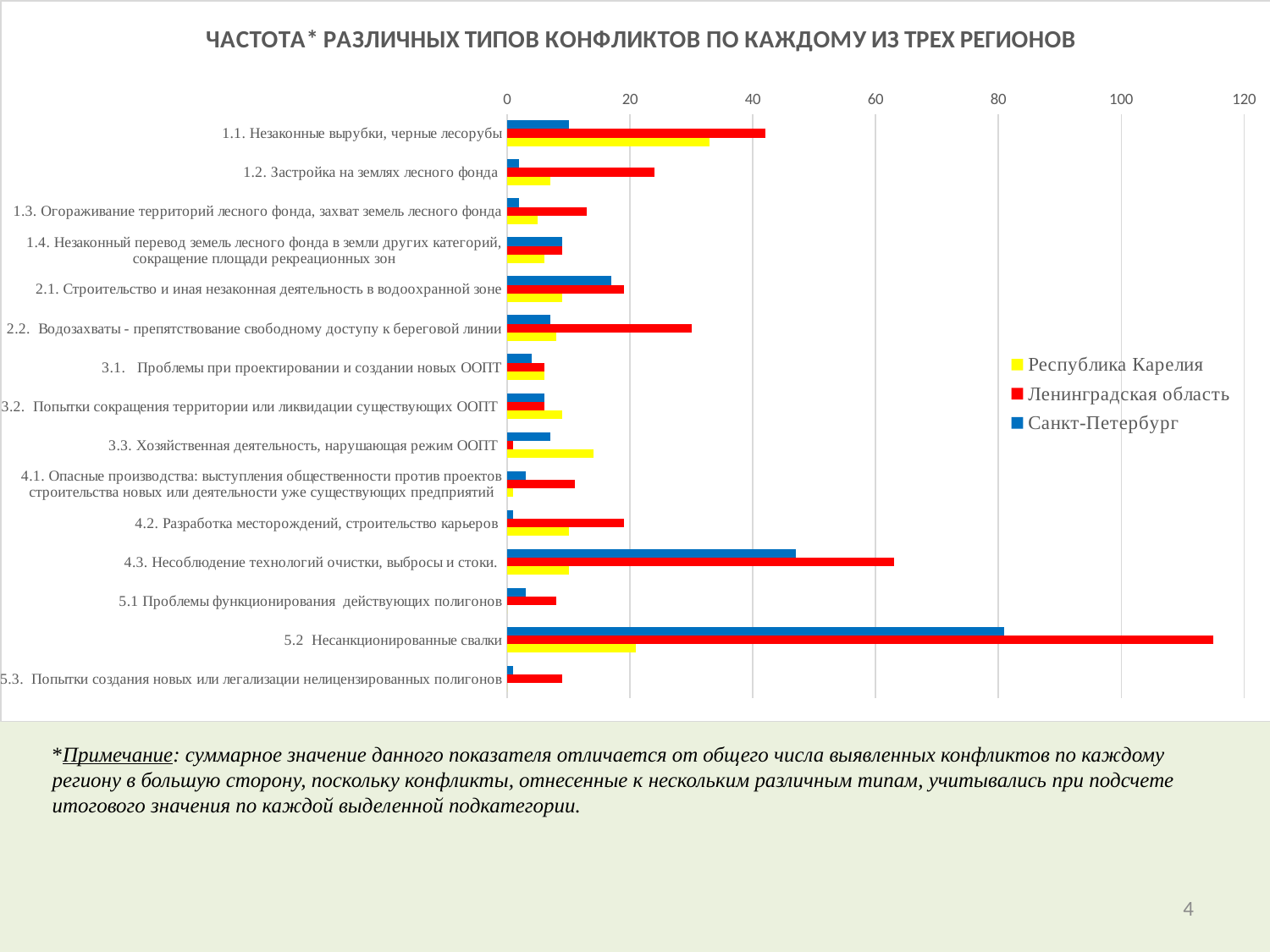
What kind of chart is shown on the slide? Bar chart How many series does the legend list? 3 Is the value for Санкт-Петербург in category 4.3. Несоблюдение технологий очистки, выбросы и стоки greater or less than 40? greater How many conflict-type categories are plotted on the chart? 15 Is the value for Ленинградская область in category 5.2 Несанкционированные свалки greater or less than 100? greater Which category has the highest value for Ленинградская область? 5.2 Несанкционированные свалки Which category has the highest value for Республика Карелия? 1.1. Незаконные вырубки, черные лесорубы In category 1.1. Незаконные вырубки, черные лесорубы, which is larger: Ленинградская область or Республика Карелия? Ленинградская область Which category has the lowest value for Ленинградская область? 3.3. Хозяйственная деятельность, нарушающая режим ООПТ Which colour represents Санкт-Петербург in the legend? Blue Which category has the highest value for Санкт-Петербург? 5.2 Несанкционированные свалки Is the value for Республика Карелия in category 1.1. Незаконные вырубки, черные лесорубы greater or less than 40? less